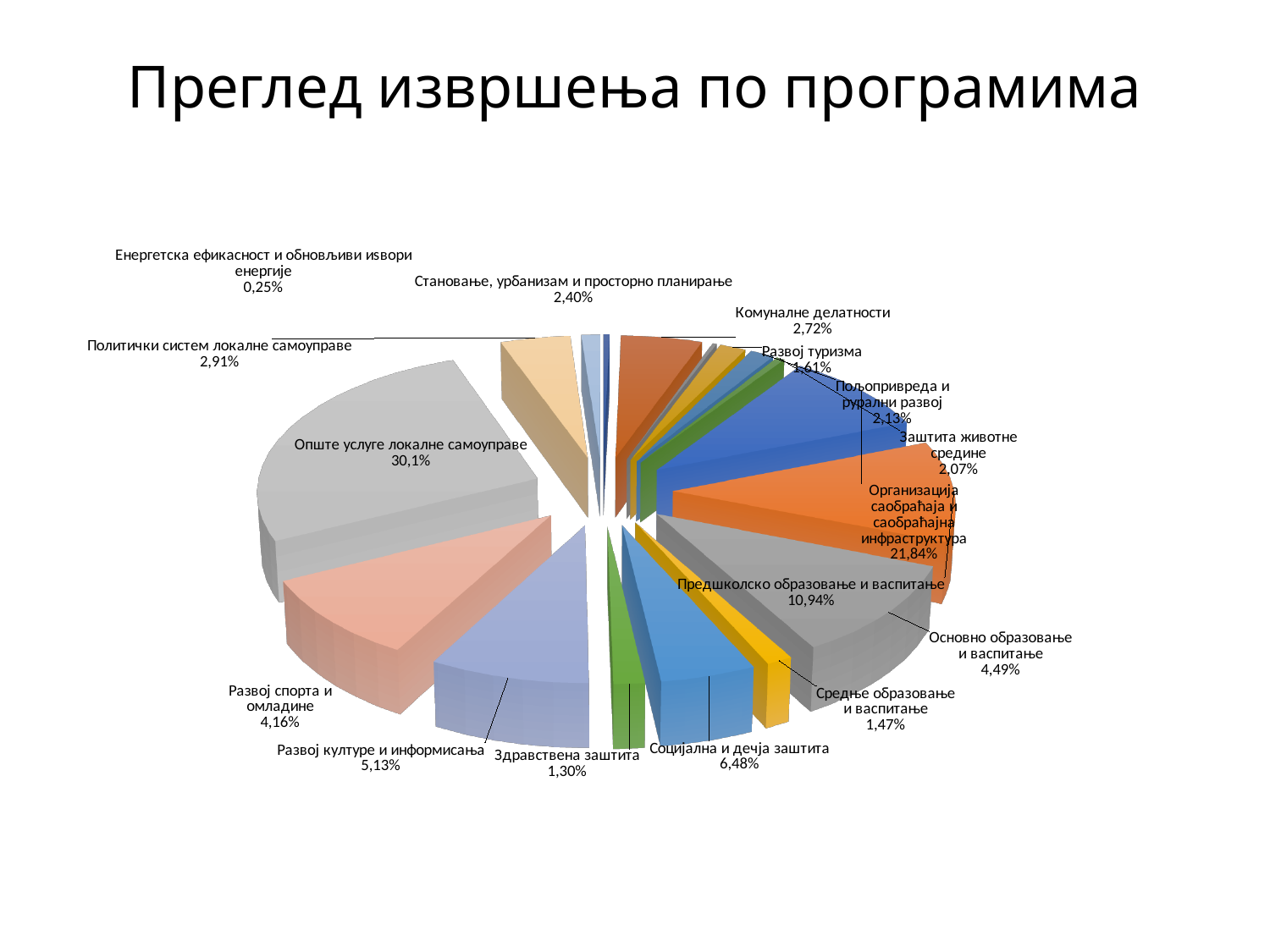
What is the value shown for Предшколско образовање и васпитање? 10,94% What is the value shown for Организација саобраћаја и саобраћајна инфраструктура? 21,84% What is the value shown for Социјална и дечја заштита? 6,48% What is the title of the chart on the slide? Преглед извршења по програмима What is the value shown for Здравствена заштита? 1,30% Which program has the largest share of the pie? Опште услуге локалне самоуправе What kind of chart is shown on the slide? Pie chart How many programs (slices) are shown in the pie chart? 17 What share of the pie does Опште услуге локалне самоуправе have? 30,1% What is the difference between the shares of Основно образовање и васпитање and Средње образовање и васпитање? 3,02% Which is larger: Развој културе и информисања or Развој спорта и омладине? Развој културе и информисања Which program has the smallest share of the pie? Енергетска ефикасност и обновљиви извори енергије